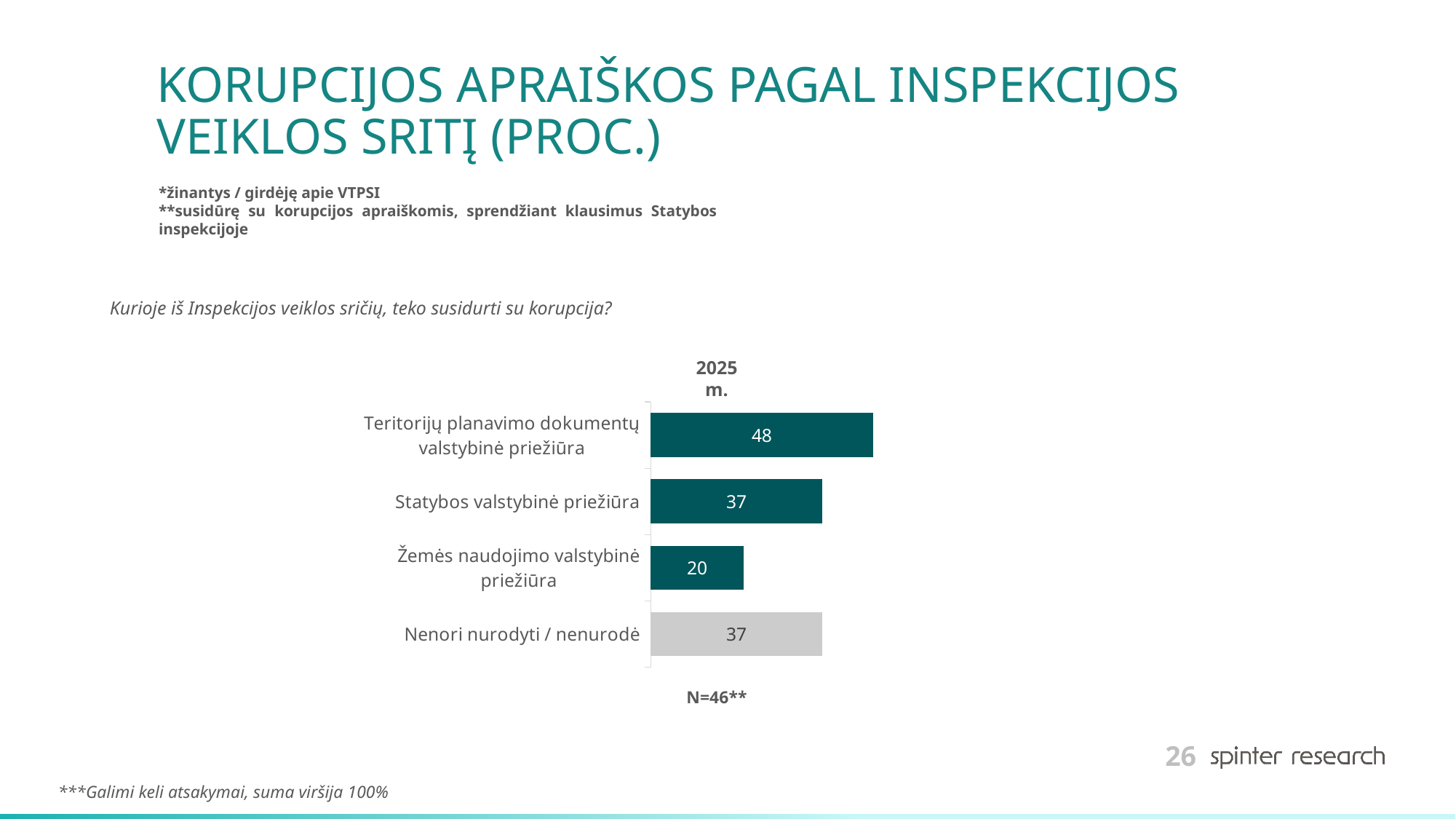
What kind of chart is shown on the slide? Bar chart How many categories are shown in the chart? 4 What is the value for "Žemės naudojimo valstybinė priežiūra"? 20 What is the value for "Nenori nurodyti / nenurodė"? 37 Which category has the lowest value? Žemės naudojimo valstybinė priežiūra What is the value for "Teritorijų planavimo dokumentų valstybinė priežiūra"? 48 What year label is shown above the bars in the chart? 2025 m. Which is larger: the value for "Teritorijų planavimo dokumentų valstybinė priežiūra" or the value for "Žemės naudojimo valstybinė priežiūra"? Teritorijų planavimo dokumentų valstybinė priežiūra What is the difference between the values for "Teritorijų planavimo dokumentų valstybinė priežiūra" and "Statybos valstybinė priežiūra"? 11 Which category has the highest value? Teritorijų planavimo dokumentų valstybinė priežiūra What is the difference between the values for "Statybos valstybinė priežiūra" and "Žemės naudojimo valstybinė priežiūra"? 17 What is the value for "Statybos valstybinė priežiūra"? 37